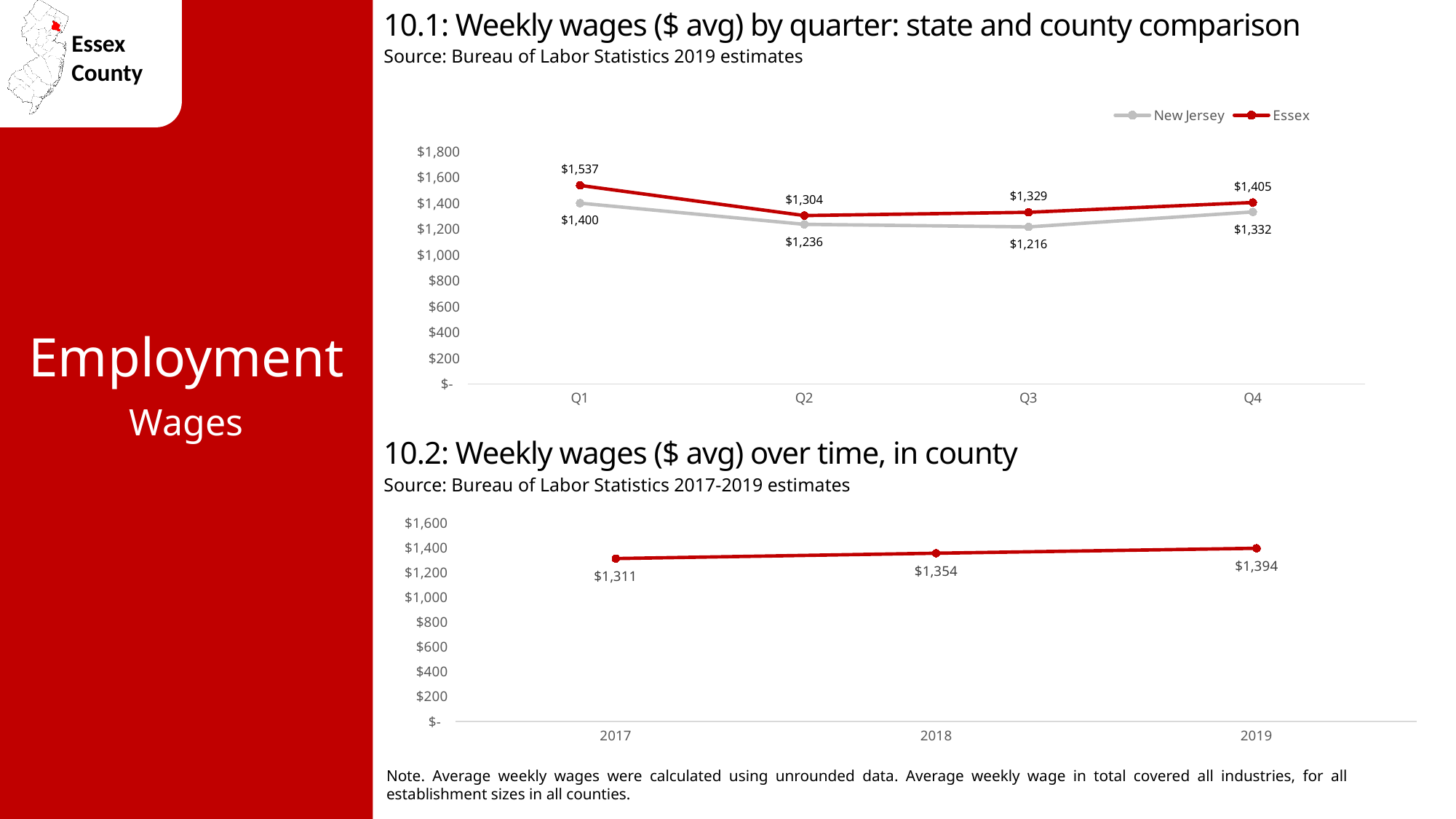
What kind of chart is chart 10.2? Line chart In chart 10.2, what is the difference between the 2019 and 2017 weekly wages? $83 In chart 10.1, what is the Essex weekly wage in Q1? $1,537 In chart 10.1, what is the difference between the Essex and New Jersey weekly wages in Q4? $73 In chart 10.1, how many quarters are plotted on the x axis? 4 In chart 10.1, which series has the higher weekly wage in Q2, New Jersey or Essex? Essex In chart 10.1, how many series does the legend list? 2 In chart 10.2, do weekly wages rise or fall from 2017 to 2019? Rise In chart 10.1, what is the New Jersey weekly wage in Q3? $1,216 In chart 10.2, what is the weekly wage in 2018? $1,354 In chart 10.1, which quarter has the lowest New Jersey weekly wage? Q3 In chart 10.1, which quarter has the highest Essex weekly wage? Q1